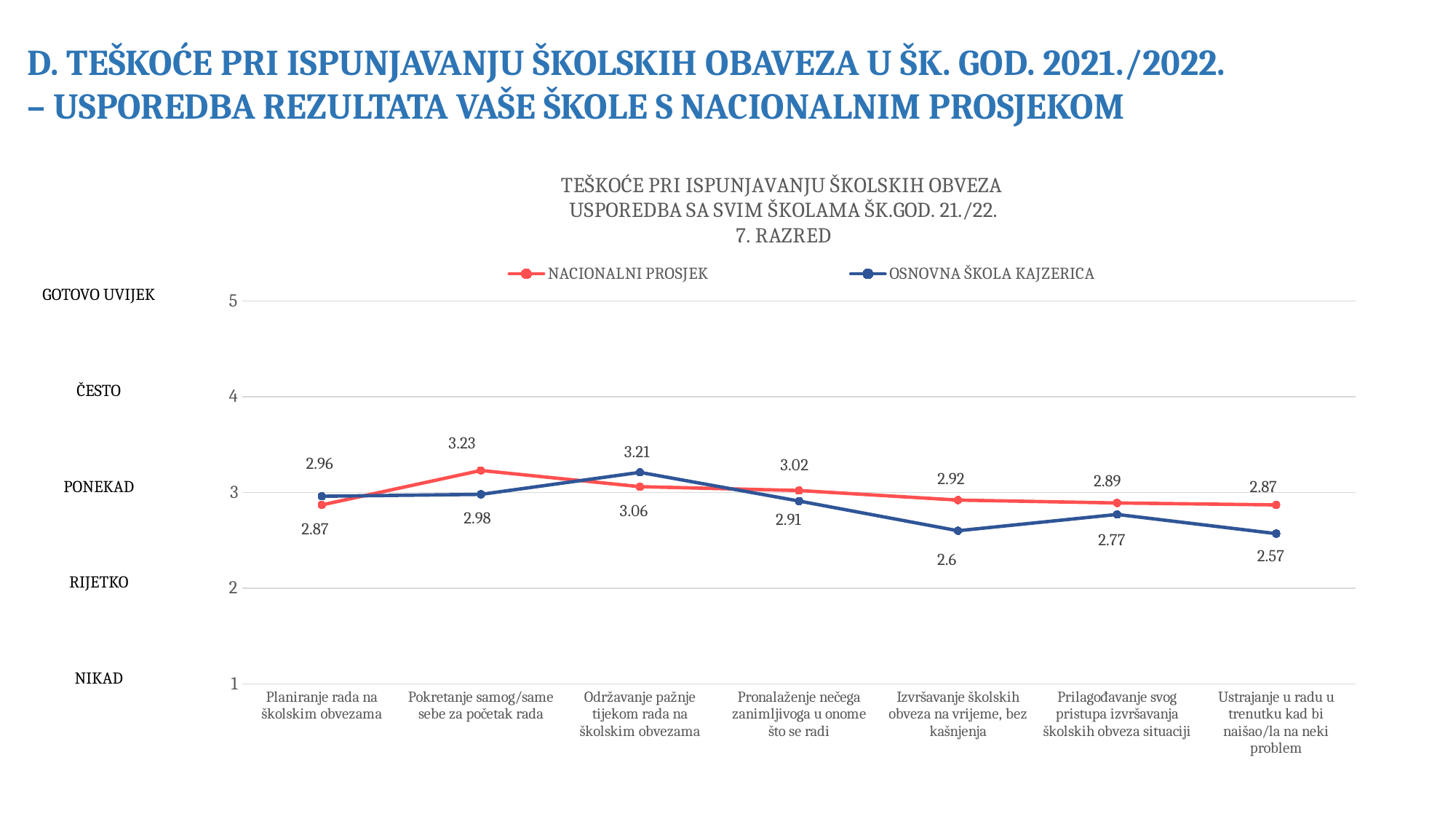
For which category is the NACIONALNI PROSJEK value highest? Pokretanje samog/same sebe za početak rada What is the OSNOVNA ŠKOLA KAJZERICA value for Održavanje pažnje tijekom rada na školskim obvezama? 3.21 Is the OSNOVNA ŠKOLA KAJZERICA value for Ustrajanje u radu u trenutku kad bi naišao/la na neki problem greater or less than 3? less What is the difference between the NACIONALNI PROSJEK and OSNOVNA ŠKOLA KAJZERICA values for Izvršavanje školskih obveza na vrijeme, bez kašnjenja? 0.32 Which colour represents OSNOVNA ŠKOLA KAJZERICA in the chart? blue What is the NACIONALNI PROSJEK value for Pokretanje samog/same sebe za početak rada? 3.23 What is the OSNOVNA ŠKOLA KAJZERICA value for Izvršavanje školskih obveza na vrijeme, bez kašnjenja? 2.6 Which series has the larger value for Pokretanje samog/same sebe za početak rada? NACIONALNI PROSJEK How many categories are shown on the x axis? 7 How many series does the legend list? 2 What kind of chart is shown? line chart For which category is the OSNOVNA ŠKOLA KAJZERICA value lowest? Ustrajanje u radu u trenutku kad bi naišao/la na neki problem